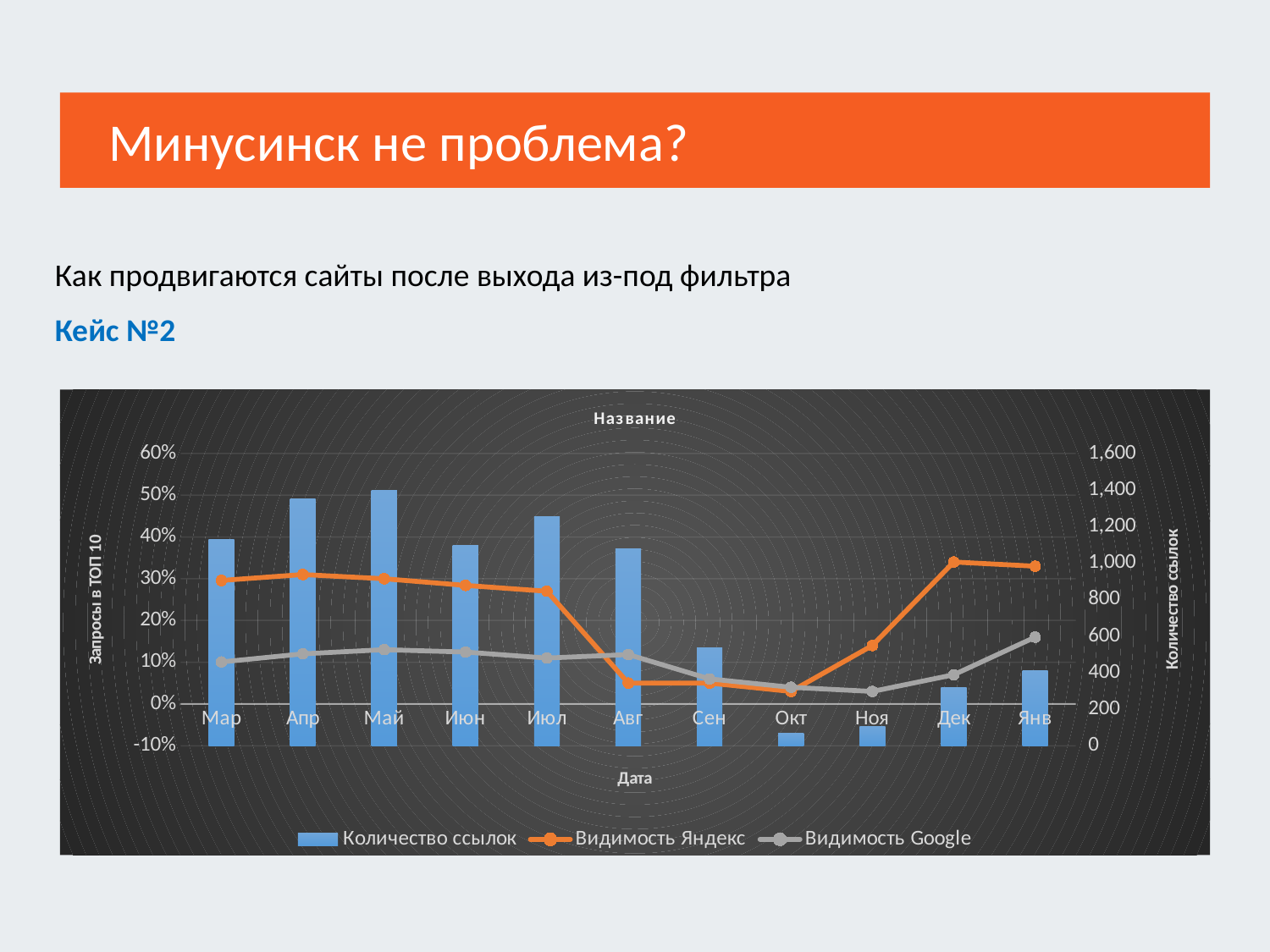
How many series does the chart legend list? 3 Is the Количество ссылок value for Окт greater or less than 200? less In which month is the Количество ссылок bar the lowest? Окт What kind of chart is shown on the slide? Combined bar and line chart In which month does the Видимость Яндекс line reach its highest point? Дек Does the Видимость Яндекс line rise or fall from Июл to Авг? fall In which month does the Видимость Google line reach its highest point? Янв Which is larger in Мар: Видимость Яндекс or Видимость Google? Видимость Яндекс In which month is the Количество ссылок bar the highest? Май What is the label of the right-hand vertical axis of the chart? Количество ссылок Is the Видимость Яндекс value for Дек greater or less than 30%? greater How many months are shown along the x axis of the chart? 11